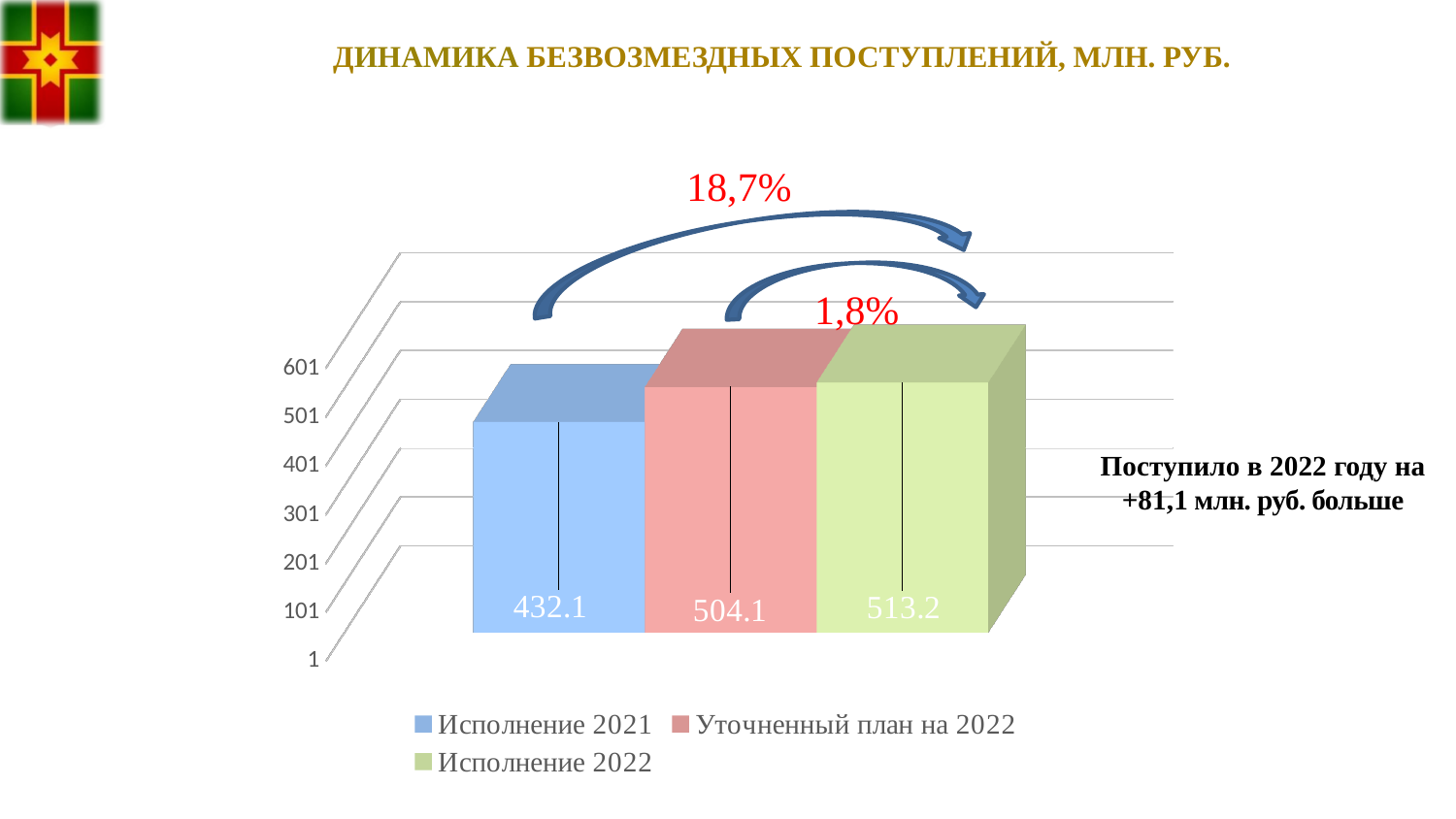
What kind of chart is shown on the slide? bar chart What is the title of the chart? ДИНАМИКА БЕЗВОЗМЕЗДНЫХ ПОСТУПЛЕНИЙ, МЛН. РУБ. Is the value for Исполнение 2021 greater or less than 401? greater How many series does the legend list? 3 What is the value for Исполнение 2022? 513.2 What is the difference between Исполнение 2022 and Исполнение 2021? 81.1 What is the difference between Исполнение 2022 and Уточненный план на 2022? 9.1 Which series has the lowest value? Исполнение 2021 Which is larger, Уточненный план на 2022 or Исполнение 2021? Уточненный план на 2022 What is the value for Уточненный план на 2022? 504.1 Which series has the highest value? Исполнение 2022 What is the value for Исполнение 2021? 432.1